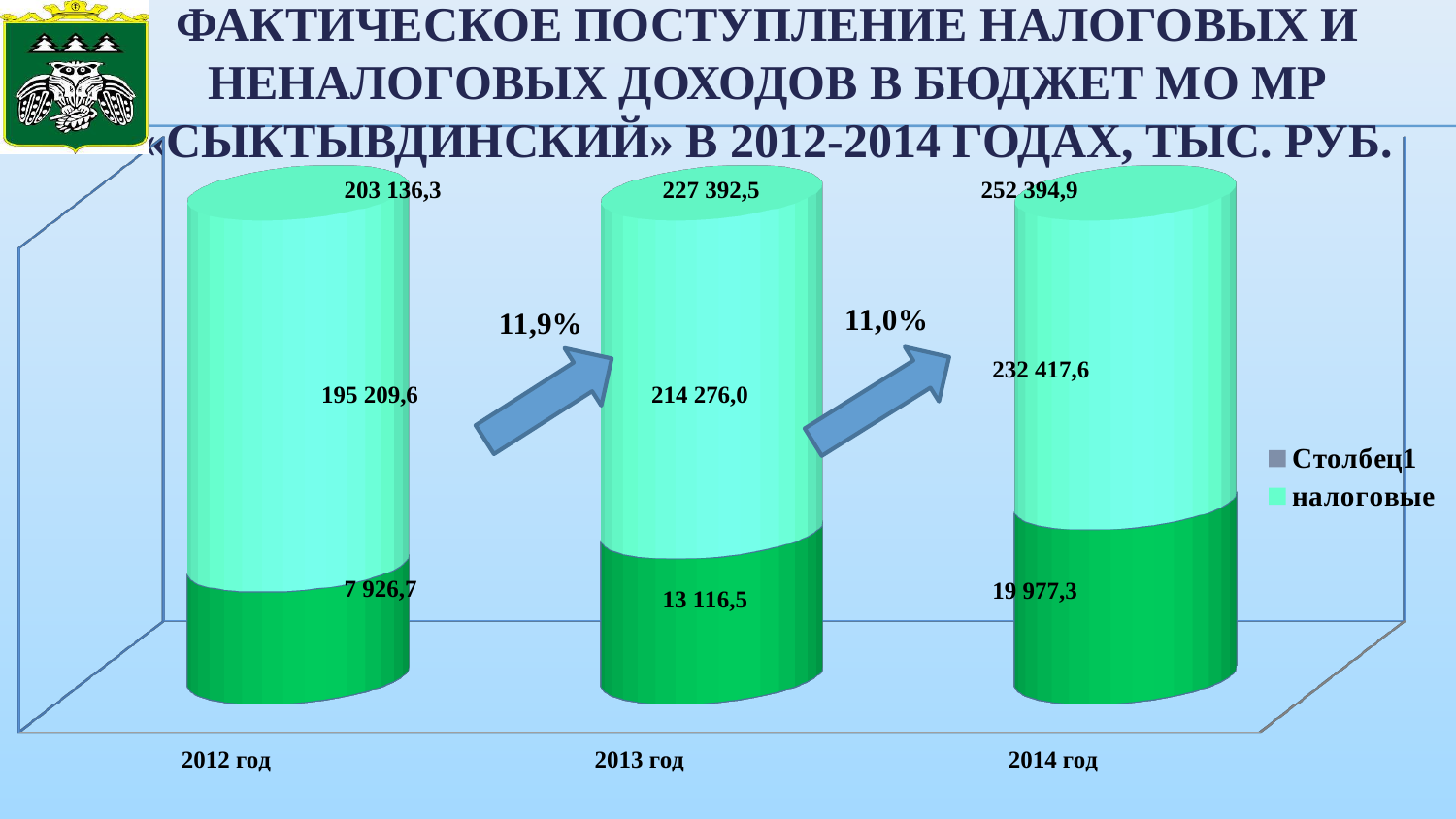
Which year has the highest value for the налоговые series? 2014 год What is the value of the налоговые series for 2013 год? 214 276,0 What is the total of the stacked bar for 2012 год? 203 136,3 Which is larger: the налоговые value for 2012 год or for 2013 год? 2013 год What is the total of the stacked bar for 2014 год? 252 394,9 Do the total values rise or fall from 2012 год to 2014 год? rise How many series does the legend list? 2 How many years are shown on the x axis? 3